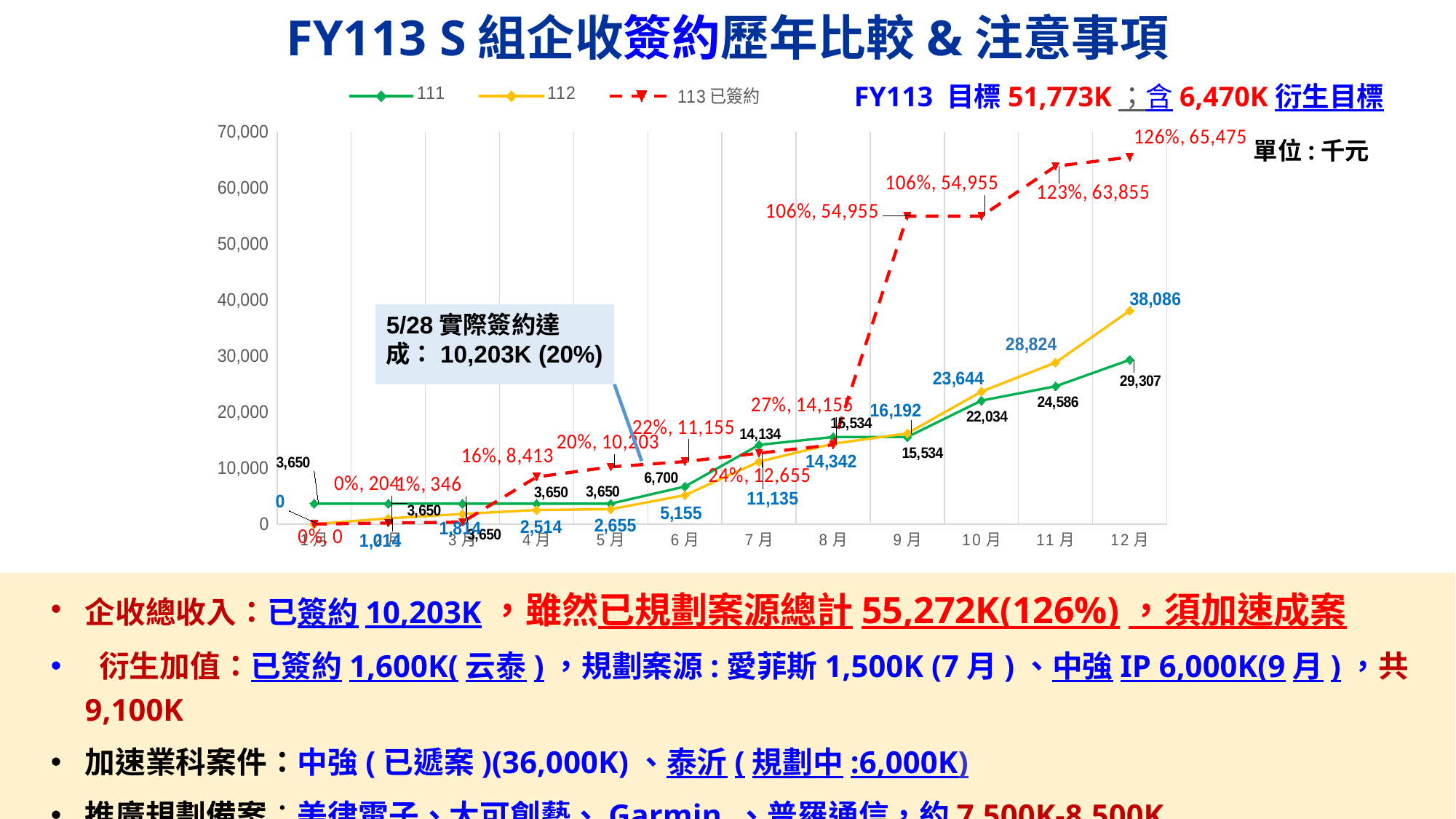
In 10月, which series is larger, 111 or 112? 112 What unit is stated for the chart values? 千元 Is the value for series 113 已簽約 in 9月 greater or less than 50,000? greater How many months are shown on the x axis? 12 What is the value of series 111 in 12月? 29,307 What is the value of series 112 in 12月? 38,086 What is the value of series 113 已簽約 in 5月? 10,203 What kind of chart is shown on the slide? line chart How many series does the legend list? 3 What is the value of series 111 in 6月? 6,700 What is the difference between series 112 and series 111 in 12月? 8,779 In which month does series 112 reach its highest value? 12月